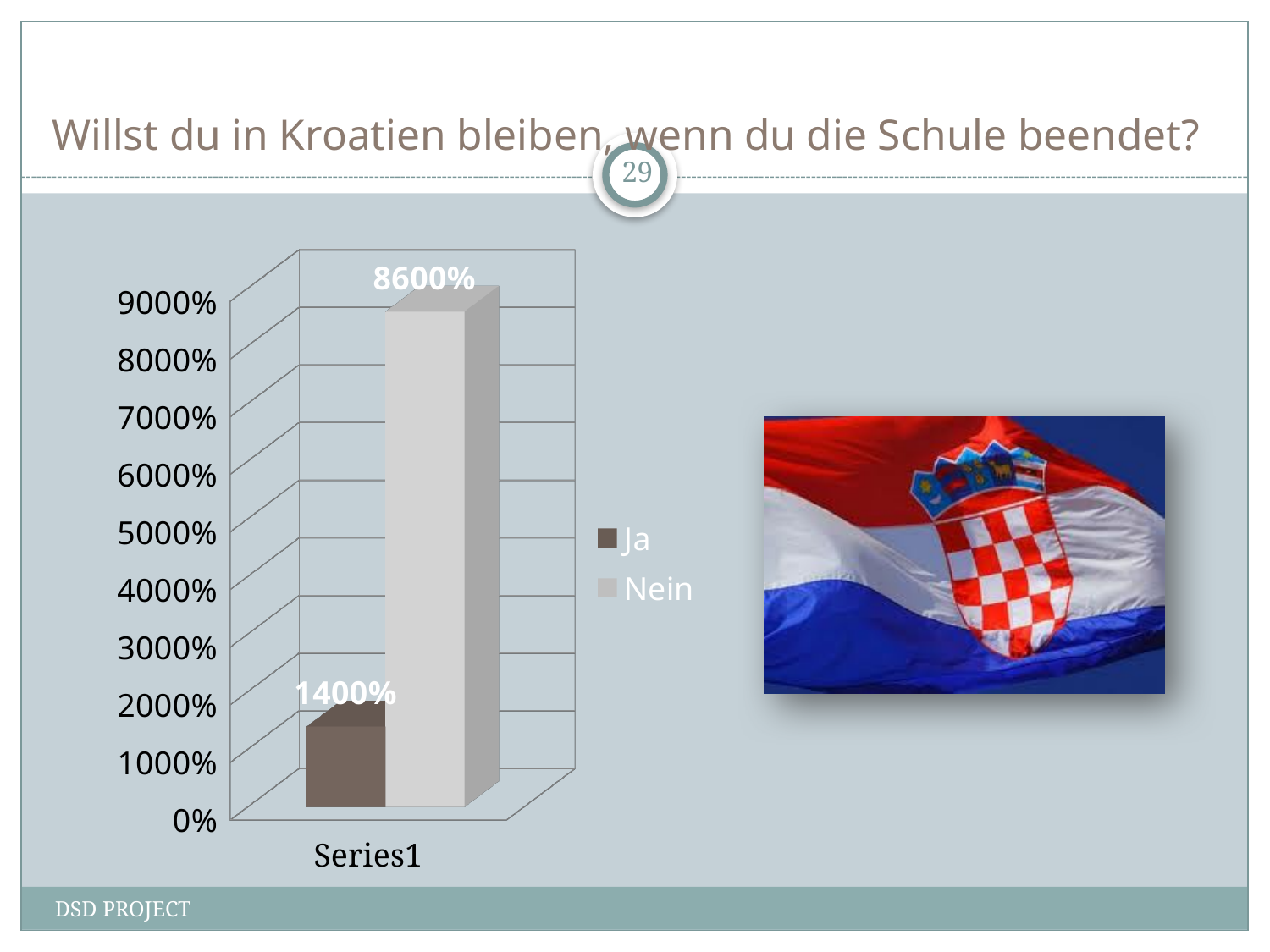
Which is larger, the value for Ja or the value for Nein? Nein What is the value for Ja? 1400% Which series has the highest value? Nein What is the value for Nein? 8600% What kind of chart is shown on the slide? bar chart Which series has the lowest value? Ja Is the value for Ja greater or less than 2000%? less What is the highest value shown on the y axis? 9000% What is the difference between the values for Nein and Ja? 7200% How many series does the legend list? 2 What is the category label shown on the x axis? Series1 Is the value for Nein greater or less than 8000%? greater